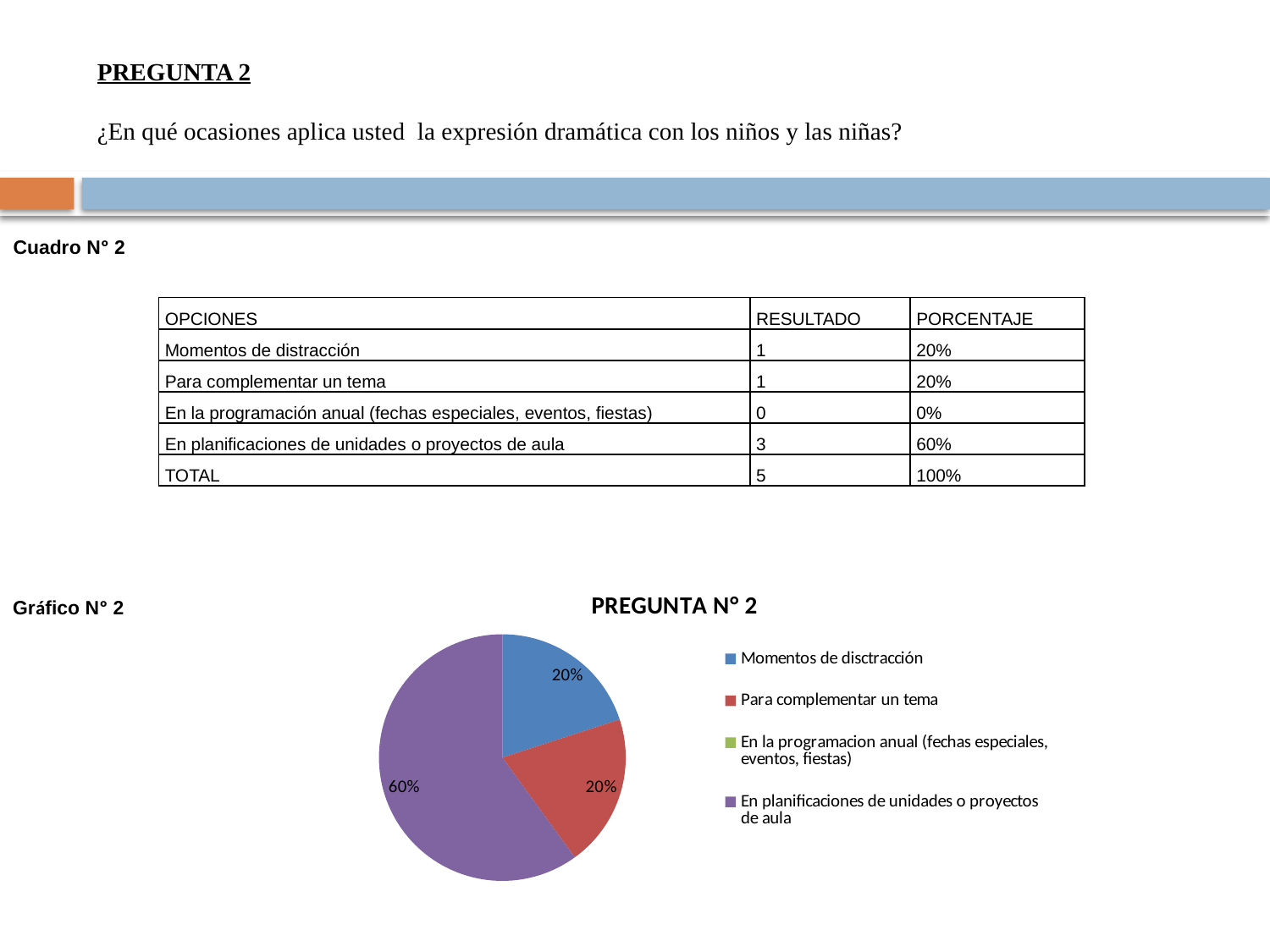
What share of the pie does "En planificaciones de unidades o proyectos de aula" represent? 60% Which is larger: the slice for "En planificaciones de unidades o proyectos de aula" or the slice for "Momentos de disctracción"? En planificaciones de unidades o proyectos de aula What is the title of the chart? PREGUNTA N° 2 What colour is the slice for "En planificaciones de unidades o proyectos de aula"? purple What share of the pie does "Para complementar un tema" represent? 20% What kind of chart is shown on the slide? pie chart What share of the pie does "Momentos de disctracción" represent? 20% What is the difference between the share for "En planificaciones de unidades o proyectos de aula" and the share for "Para complementar un tema"? 40% Is the share for "En planificaciones de unidades o proyectos de aula" greater or less than 50%? greater Which category has the largest slice of the pie? En planificaciones de unidades o proyectos de aula How many categories does the legend list? 4